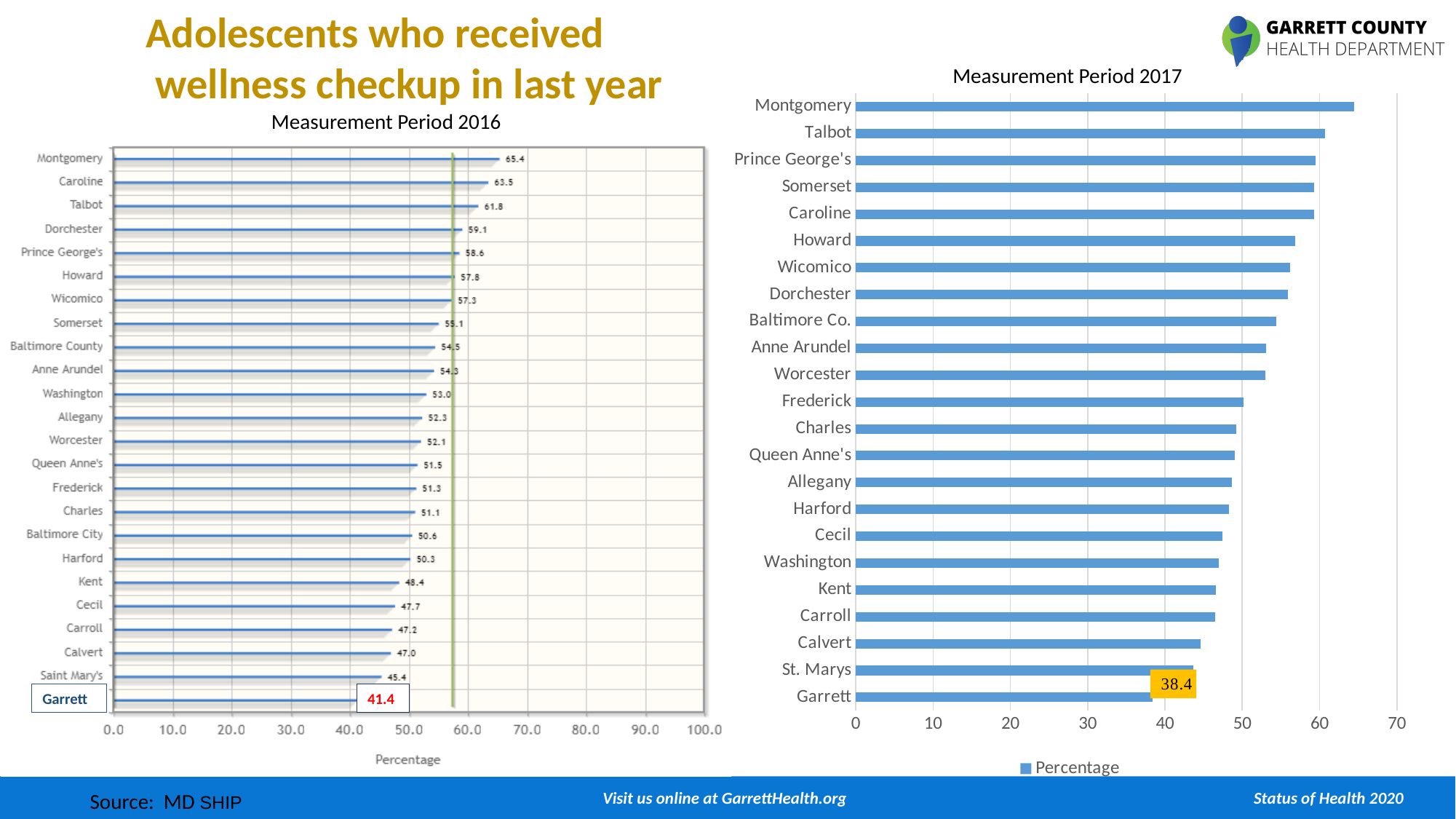
In the Measurement Period 2016 chart, which county has the lowest value? Garrett In the Measurement Period 2017 chart, is the value for Montgomery greater or less than 60? greater In the Measurement Period 2016 chart, what is the difference between Montgomery and Garrett? 24.0 In the Measurement Period 2017 chart, what is the value for Garrett? 38.4 In the Measurement Period 2016 chart, what is the value for Garrett? 41.4 How many counties are shown in the Measurement Period 2017 chart? 23 In the Measurement Period 2016 chart, which is larger, Caroline or Talbot? Caroline In the Measurement Period 2016 chart, what is the value for Kent? 48.4 What kind of chart is the Measurement Period 2017 chart? Bar chart In the Measurement Period 2017 chart, is the value for Calvert greater or less than 50? less In the Measurement Period 2016 chart, what is the value for Montgomery? 65.4 In the Measurement Period 2017 chart, which county has the highest value? Montgomery